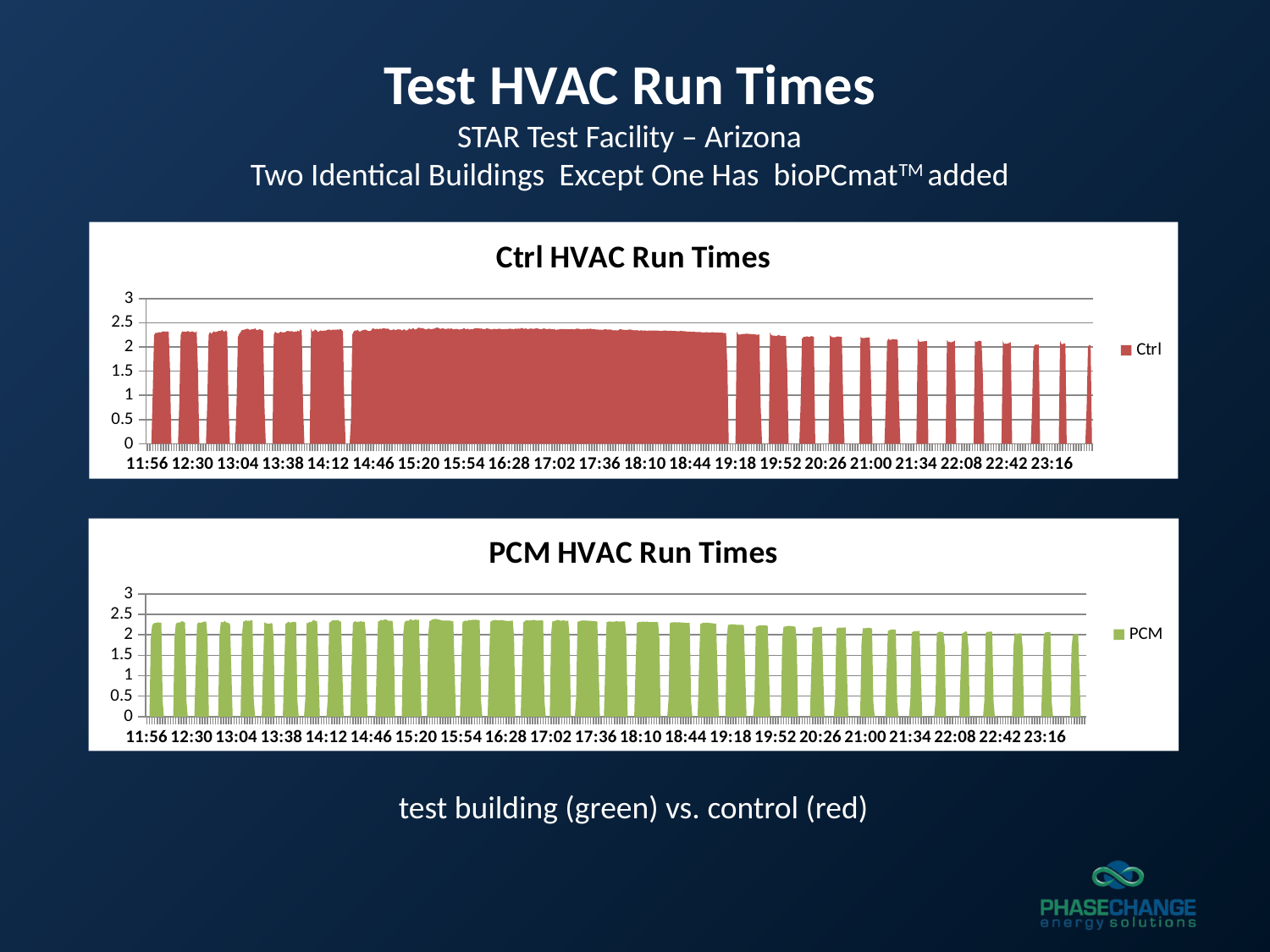
What kind of chart is the Ctrl HVAC Run Times chart? bar chart What colour are the bars in the Ctrl HVAC Run Times chart? red How many series does the legend of the Ctrl HVAC Run Times chart list? 1 What is the first time label on the x axis of the Ctrl HVAC Run Times chart? 11:56 What kind of chart is the PCM HVAC Run Times chart? bar chart In the Ctrl HVAC Run Times chart, is the peak value around 14:46 greater or less than 2? greater What is the legend entry on the PCM HVAC Run Times chart? PCM In the Ctrl HVAC Run Times chart, do the peak bar heights rise or fall from 11:56 to 23:16? fall What is the highest value shown on the y axis of the PCM HVAC Run Times chart? 3 In the PCM HVAC Run Times chart, is the peak value around 12:30 greater or less than 1.5? greater In the Ctrl HVAC Run Times chart, is the peak value around 14:46 greater or less than 2.5? less